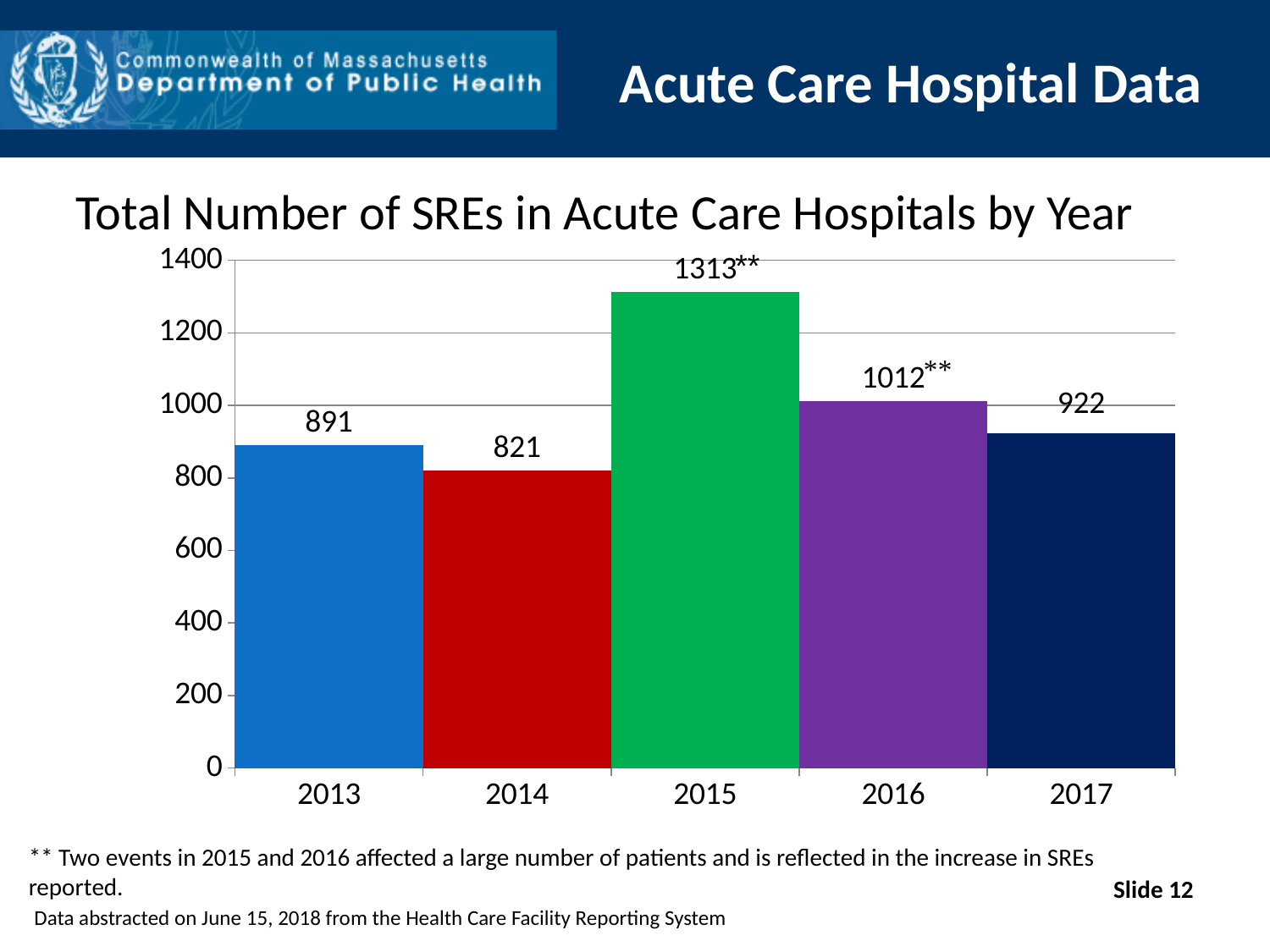
Which year has the highest total number of SREs? 2015 What is the total number of SREs in acute care hospitals in 2017? 922 What is the difference between the number of SREs in 2015 and 2014? 492 What is the title of the chart? Total Number of SREs in Acute Care Hospitals by Year What is the total number of SREs in acute care hospitals in 2013? 891 Is the value for 2015 greater or less than 1200? greater How many years are shown on the chart? 5 Which year has the lowest total number of SREs? 2014 What kind of chart is shown on the slide? Bar chart Which year had more SREs, 2016 or 2017? 2016 What is the total number of SREs in acute care hospitals in 2014? 821 What is the difference between the number of SREs in 2017 and 2013? 31